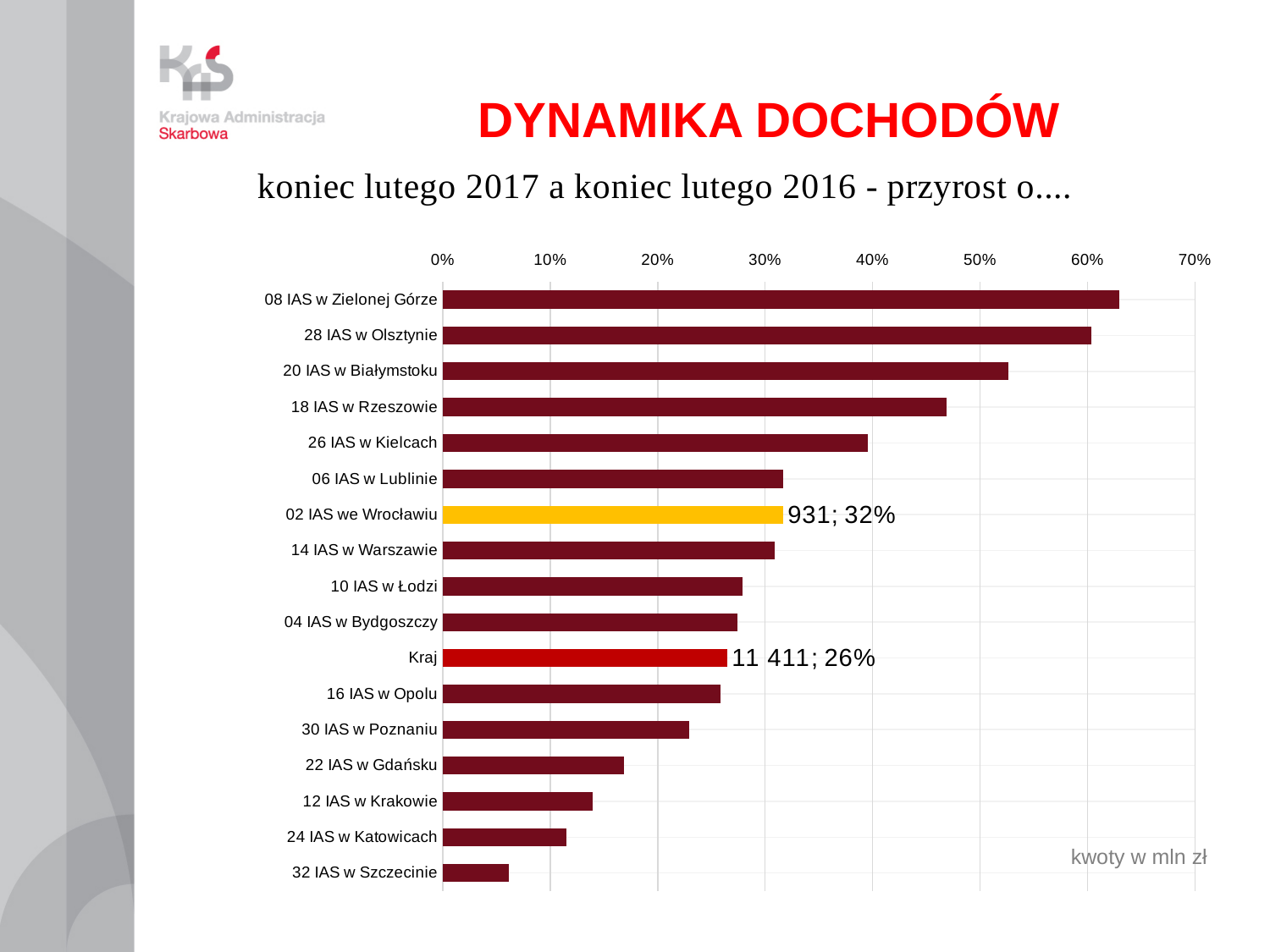
How many categories are plotted in the chart? 17 What is the difference between the percentage for 02 IAS we Wrocławiu and the percentage for Kraj? 6 percentage points What colour is the bar for 02 IAS we Wrocławiu? yellow What percentage is shown for Kraj? 26% Which category has the highest value in the chart? 08 IAS w Zielonej Górze What amount (in mln zł) is labelled for Kraj? 11 411 What percentage is shown for 02 IAS we Wrocławiu? 32% Which category has the lowest value in the chart? 32 IAS w Szczecinie Is the value for 08 IAS w Zielonej Górze greater or less than 60%? greater What kind of chart is shown on the slide? bar chart Is the value for 32 IAS w Szczecinie greater or less than 10%? less Which has the larger value, 28 IAS w Olsztynie or 20 IAS w Białymstoku? 28 IAS w Olsztynie